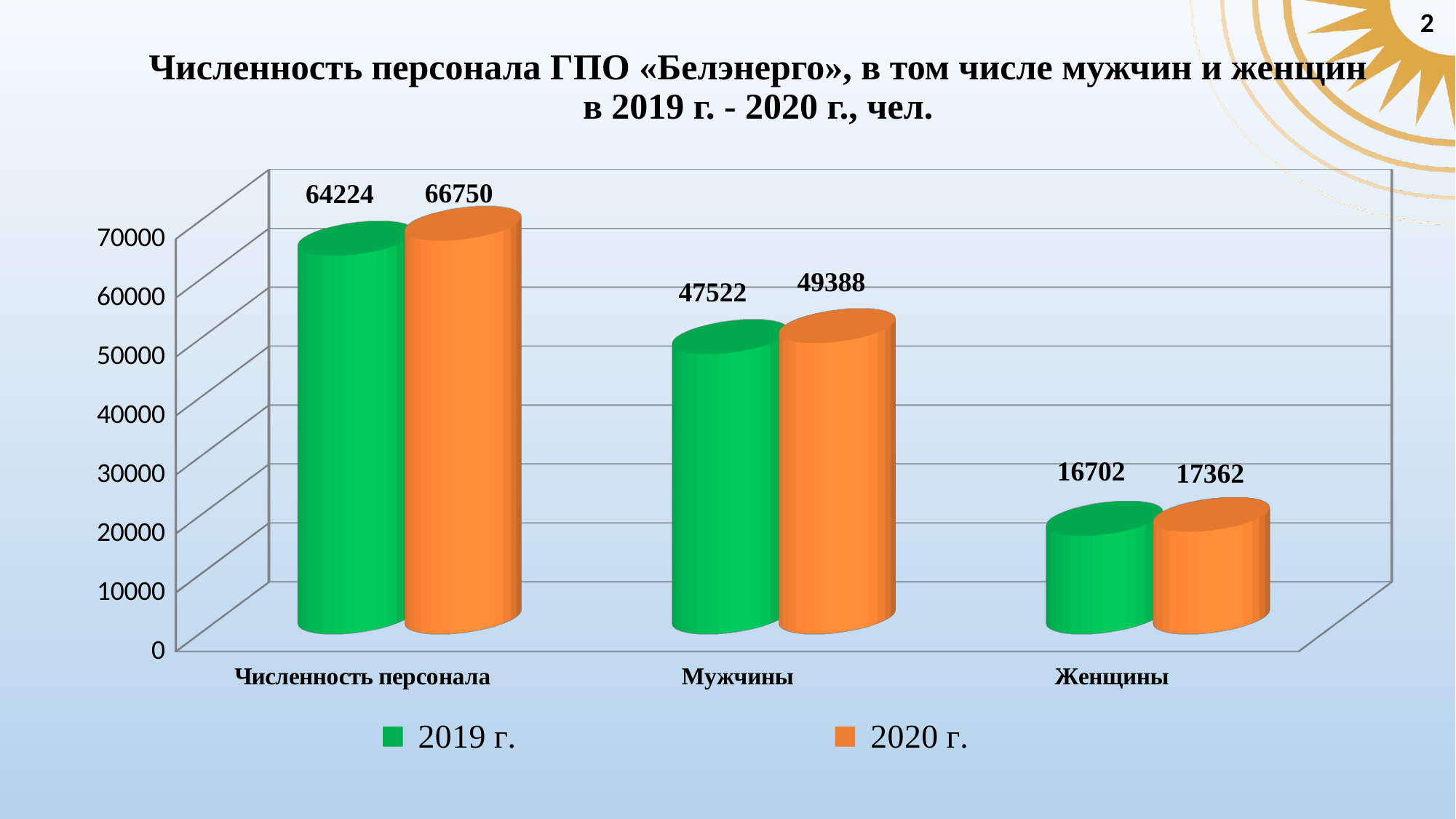
What is the value for Мужчины in 2020 г.? 49388 Which is larger: the value for Мужчины in 2019 г. or in 2020 г.? 2020 г. Which category has the lowest value in 2020 г.? Женщины How many categories are shown on the x axis? 3 What is the difference between the 2020 г. and 2019 г. values for Мужчины? 1866 What is the value for Женщины in 2020 г.? 17362 What is the value for Численность персонала in 2019 г.? 64224 Which category has the highest value in 2019 г.? Численность персонала How many series does the legend list? 2 What kind of chart is shown on the slide? Bar chart What is the value for Женщины in 2019 г.? 16702 What is the difference between the 2020 г. and 2019 г. values for Численность персонала? 2526